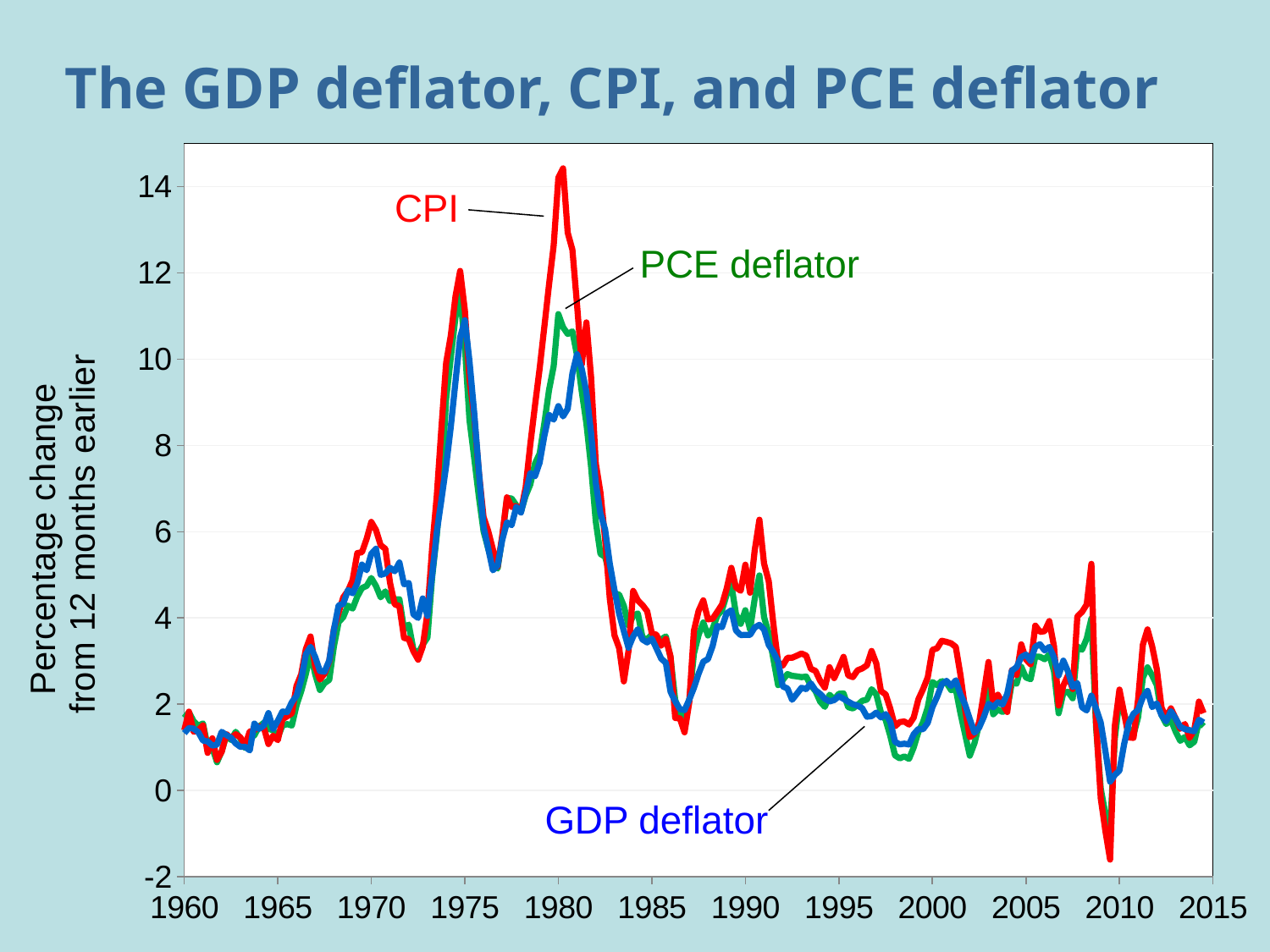
Do the values of the three series rise or fall between 1965 and 1970? rise What is the label on the vertical axis? Percentage change from 12 months earlier What kind of chart is shown on the slide? line chart At the peak around 1980, which is higher, the CPI or the GDP deflator? CPI Is the CPI value at its peak around 1980 greater or less than 12? greater Which series reaches the lowest value on the chart? CPI What is the title of the chart? The GDP deflator, CPI, and PCE deflator Is the lowest CPI value around 2009 greater or less than 0? less Is the GDP deflator value in 1960 greater or less than 4? less Do the values of the three series rise or fall between 1980 and 1985? fall How many series are plotted on the chart? 3 Which series reaches the highest value on the chart? CPI